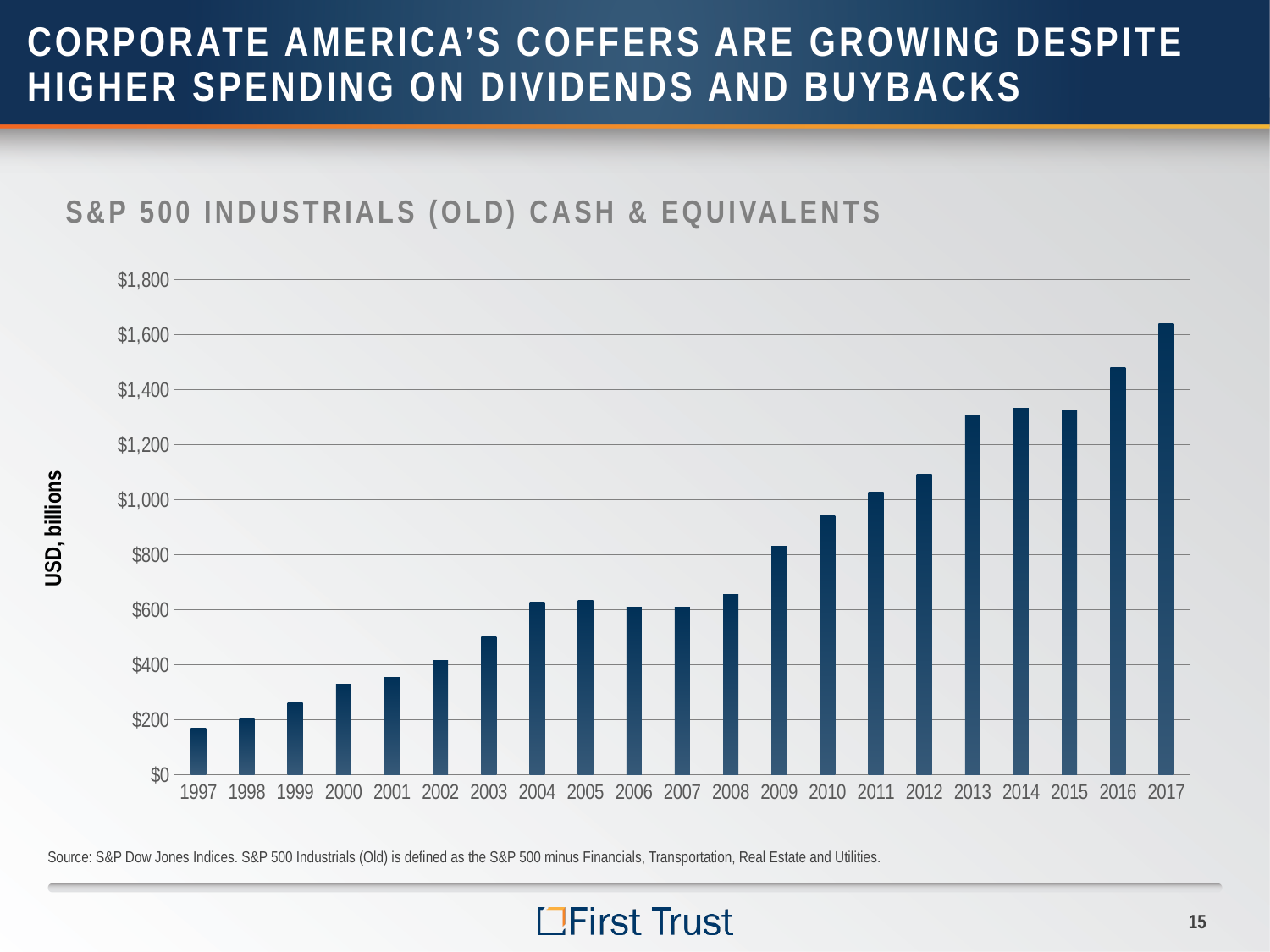
What is the title of the chart? S&P 500 Industrials (Old) Cash & Equivalents Which year has the larger value, 2012 or 2013? 2013 Is the value for 1997 greater or less than $200? less What is the label on the vertical axis of the chart? USD, billions Which year has the highest cash & equivalents value? 2017 Is the value for 2009 greater or less than $800? greater Is the value for 2016 greater or less than $1,600? less How many years are plotted on the chart? 21 Which year has the lowest cash & equivalents value? 1997 Do the values generally rise or fall from 1997 to 2017? rise What kind of chart is shown on the slide? bar chart